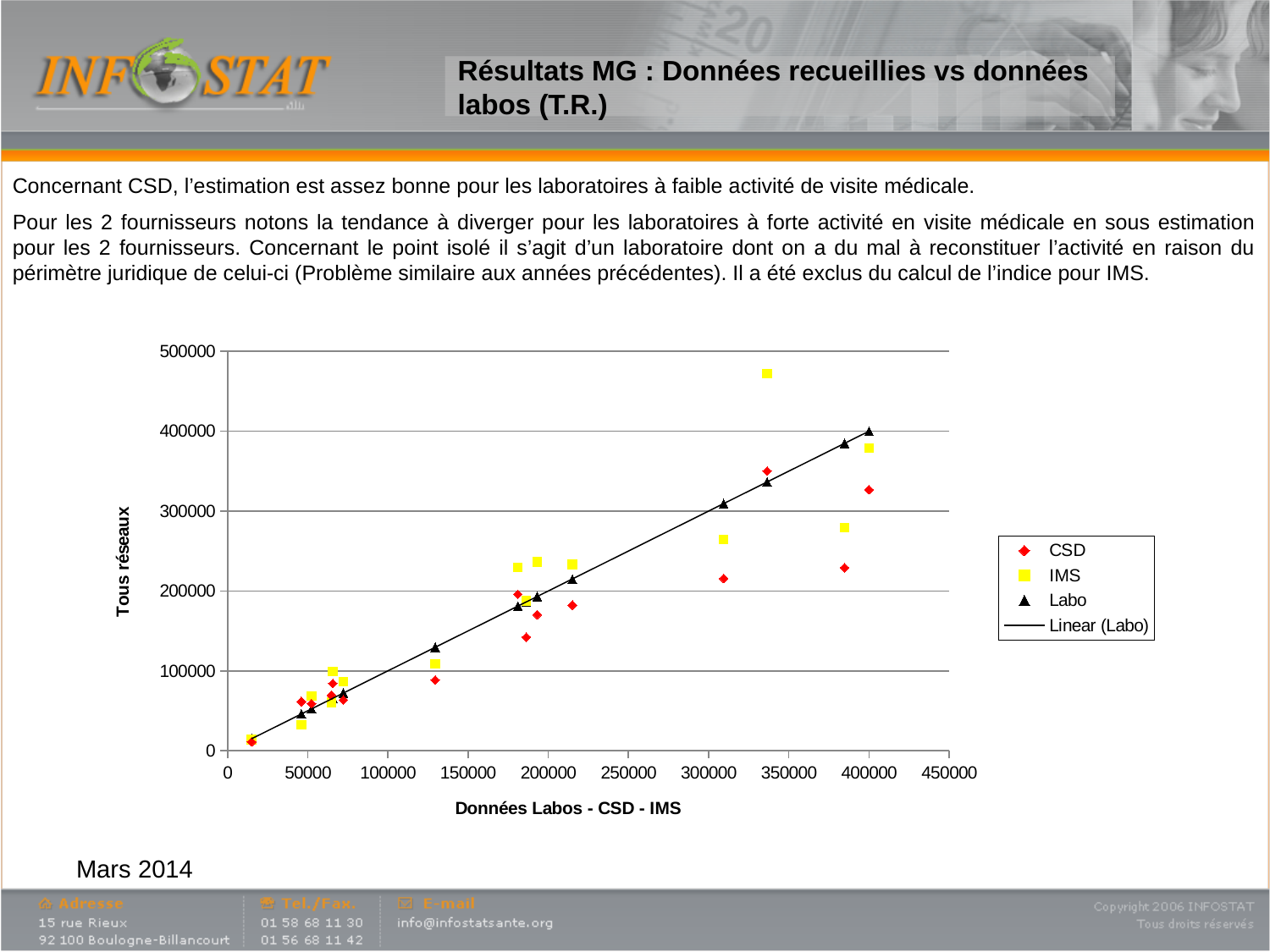
Do the Labo points rise or fall as the x-axis value increases? rise What kind of chart is shown on the slide? scatter chart Which series has the highest point: CSD or IMS? IMS Is the highest CSD point greater or less than 400000 on the y axis? less What is the title of the y axis? Tous réseaux Is the highest CSD point greater or less than 300000 on the y axis? greater Is the highest IMS point greater or less than 400000 on the y axis? greater How many series does the legend list? 4 Which series is plotted with yellow square markers? IMS Which series has the highest plotted point on the chart? IMS What is the title of the x axis? Données Labos - CSD - IMS